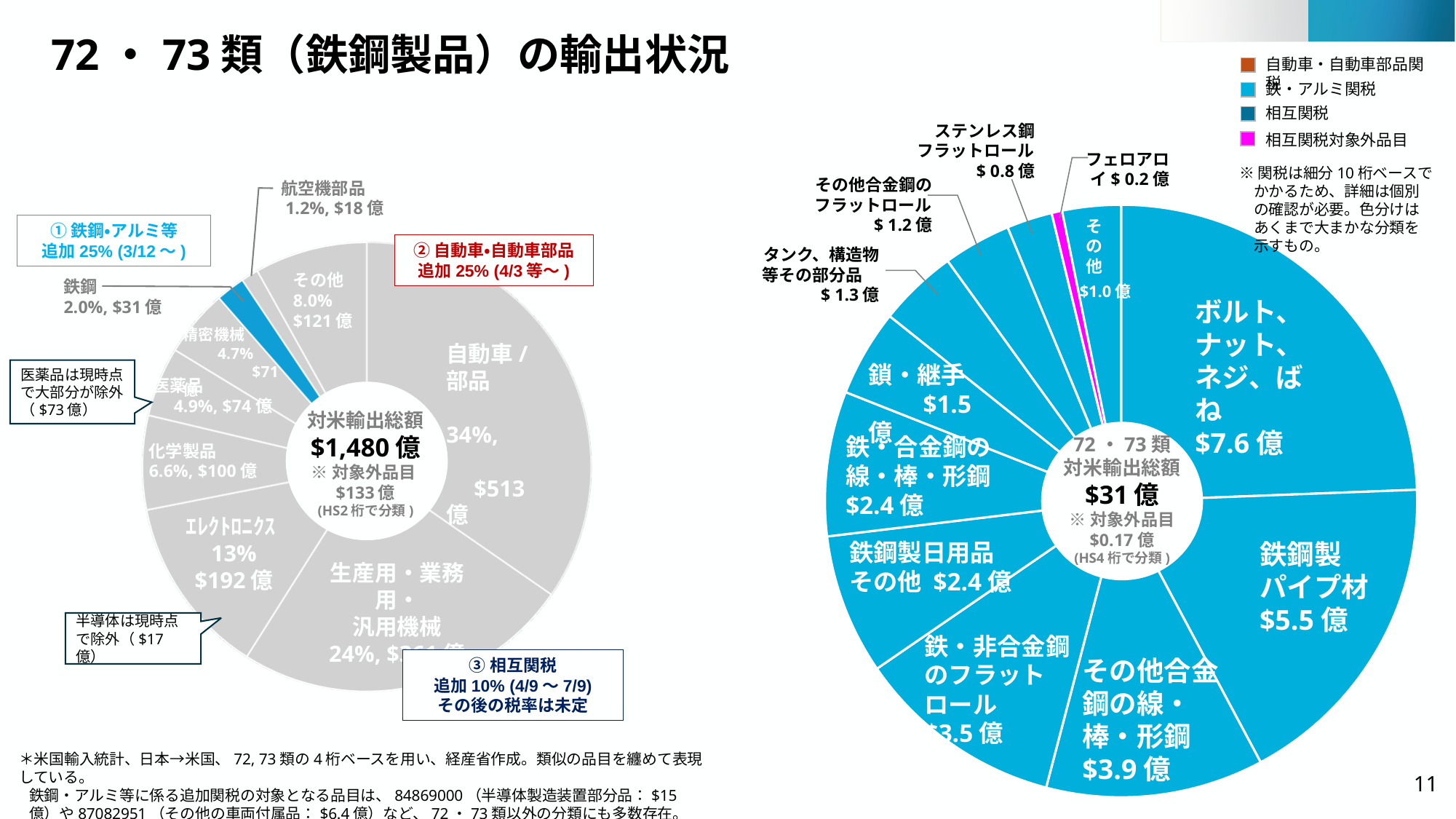
On the left chart (対米輸出総額), what is the value for 自動車/部品? 34%, $513億 On the left chart (対米輸出総額), what is the difference in value between 化学製品 and 医薬品? $26億 On the left chart (対米輸出総額), what is the value for 鉄鋼? 2.0%, $31億 On the left chart (対米輸出総額), what is the value for エレクトロニクス? 13%, $192億 On the left chart (対米輸出総額), which category has the smallest share? 航空機部品 On the left chart (対米輸出総額), what is the total export amount shown in the centre? $1,480億 On the right chart (72・73類 対米輸出総額), what is the value for 鉄鋼製パイプ材? $5.5億 On the right chart (72・73類 対米輸出総額), which category has the smallest value? フェロアロイ On the right chart (72・73類 対米輸出総額), which category has the largest value? ボルト、ナット、ネジ、ばね On the right chart (72・73類 対米輸出総額), what is the difference between ボルト、ナット、ネジ、ばね and 鉄鋼製パイプ材? $2.1億 How many entries does the legend at the top right of the slide list? 4 On the right chart (72・73類 対米輸出総額), which is larger: その他合金鋼の線・棒・形鋼 or 鉄・非合金鋼のフラットロール? その他合金鋼の線・棒・形鋼